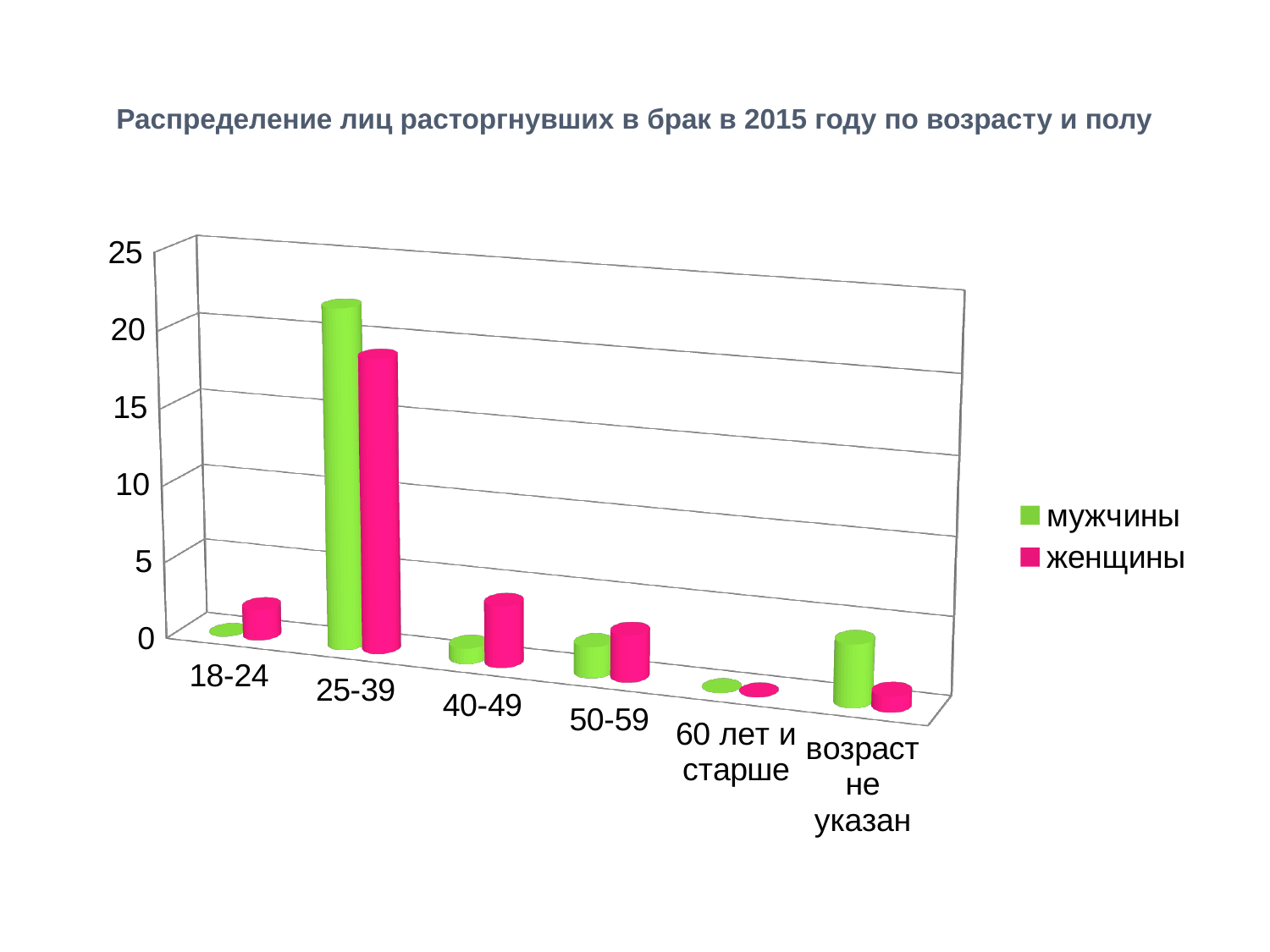
In the 25-39 category, which series has the larger value, мужчины or женщины? мужчины Which age category has the highest value for женщины? 25-39 How many series does the legend list? 2 Is the value for женщины in the 40-49 category greater or less than 5? less Which colour represents the series женщины in the legend? pink Is the value for женщины in the 25-39 category greater or less than 20? less How many age categories are shown on the x axis? 6 In the 18-24 category, which series has the larger value, мужчины or женщины? женщины Is the value for мужчины in the 25-39 category greater or less than 15? greater Which age category has the highest value for мужчины? 25-39 In the 'возраст не указан' category, which series has the larger value, мужчины or женщины? мужчины What kind of chart is shown on the slide? bar chart